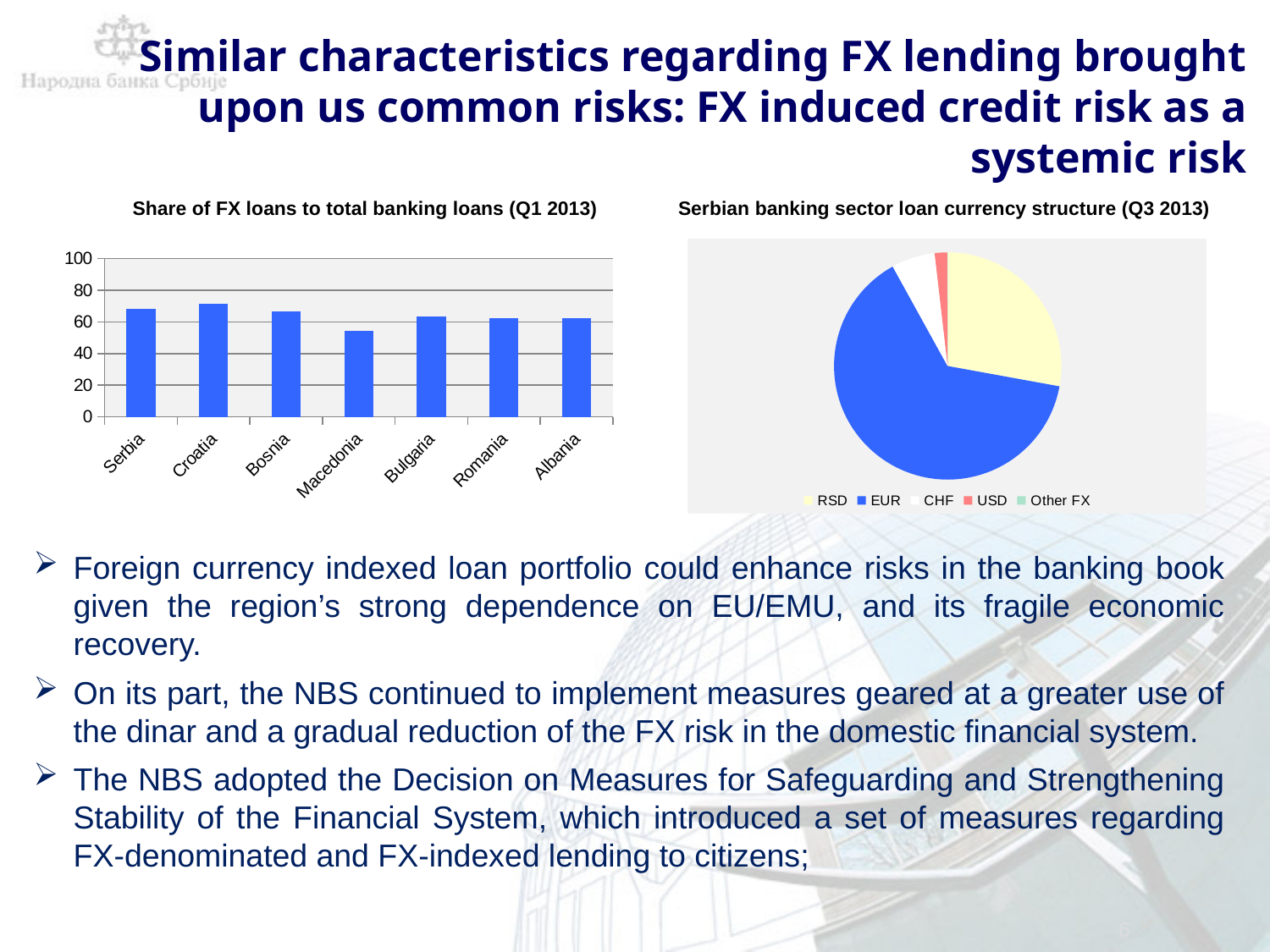
In the 'Share of FX loans to total banking loans (Q1 2013)' chart, is the value for Croatia greater or less than 60? greater In the 'Share of FX loans to total banking loans (Q1 2013)' chart, which country has the highest share? Croatia In the 'Serbian banking sector loan currency structure (Q3 2013)' chart, what colour is the EUR slice? blue In the 'Share of FX loans to total banking loans (Q1 2013)' chart, which is larger, the value for Croatia or the value for Macedonia? Croatia In the 'Share of FX loans to total banking loans (Q1 2013)' chart, is the value for Macedonia greater or less than 60? less In the 'Serbian banking sector loan currency structure (Q3 2013)' chart, how many currency categories does the legend list? 5 In the 'Share of FX loans to total banking loans (Q1 2013)' chart, which country has the lowest share? Macedonia In the 'Share of FX loans to total banking loans (Q1 2013)' chart, how many countries are shown? 7 What kind of chart is the 'Share of FX loans to total banking loans (Q1 2013)' chart? bar chart In the 'Serbian banking sector loan currency structure (Q3 2013)' chart, which currency has the largest slice? EUR In the 'Share of FX loans to total banking loans (Q1 2013)' chart, is the value for Serbia greater or less than 80? less What kind of chart is the 'Serbian banking sector loan currency structure (Q3 2013)' chart? pie chart